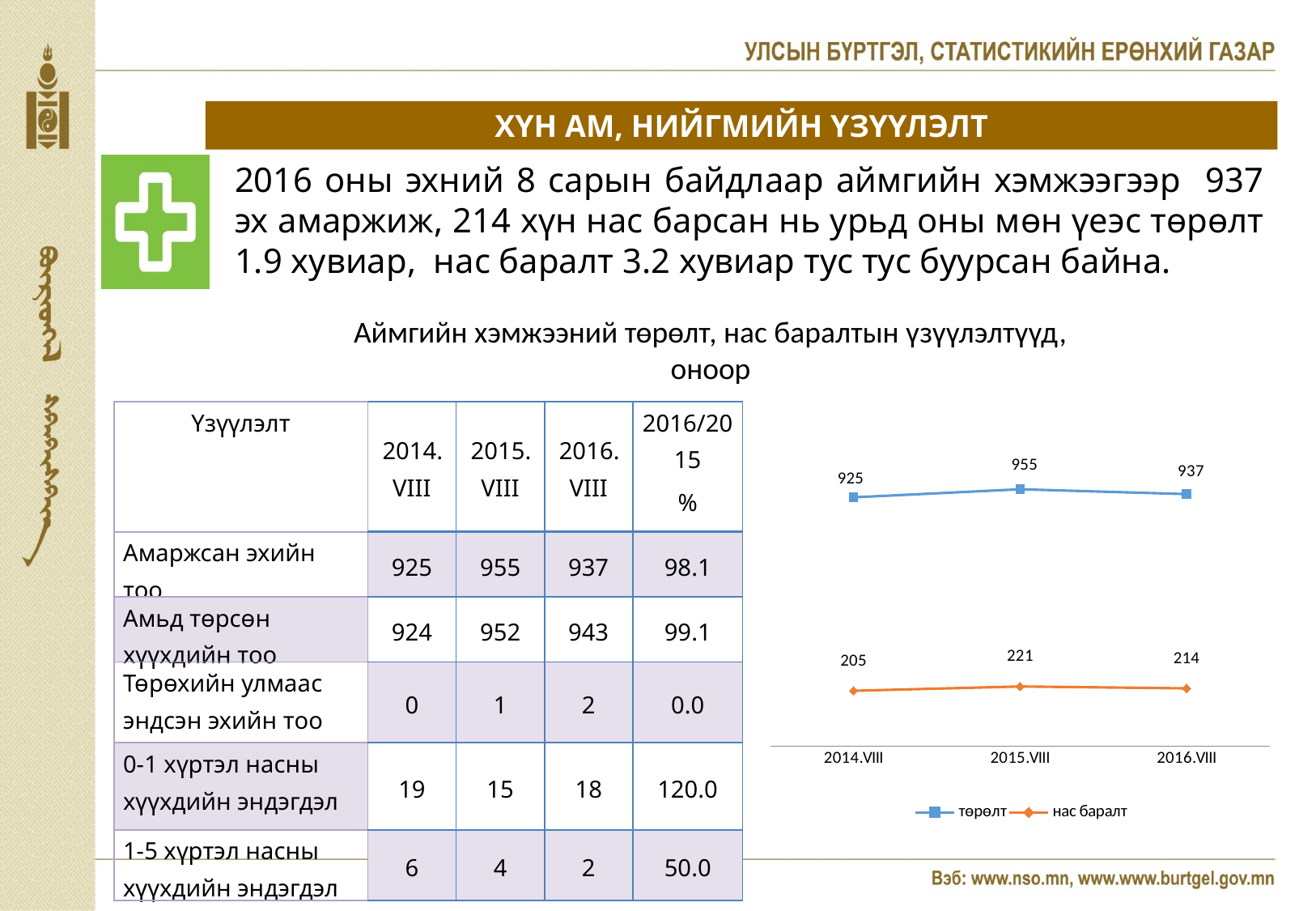
What is the difference between нас баралт in 2015.VIII and 2014.VIII? 16 Which is larger: төрөлт in 2016.VIII or төрөлт in 2014.VIII? 2016.VIII What type of chart is shown on the slide? line chart How many periods are shown on the x axis of the chart? 3 In which period is төрөлт highest? 2015.VIII Which series is drawn in orange in the chart? нас баралт What is the value of төрөлт for 2015.VIII? 955 What is the value of төрөлт for 2014.VIII? 925 In which period is нас баралт lowest? 2014.VIII What is the difference between төрөлт in 2015.VIII and 2016.VIII? 18 How many series does the chart legend list? 2 What is the value of нас баралт for 2016.VIII? 214